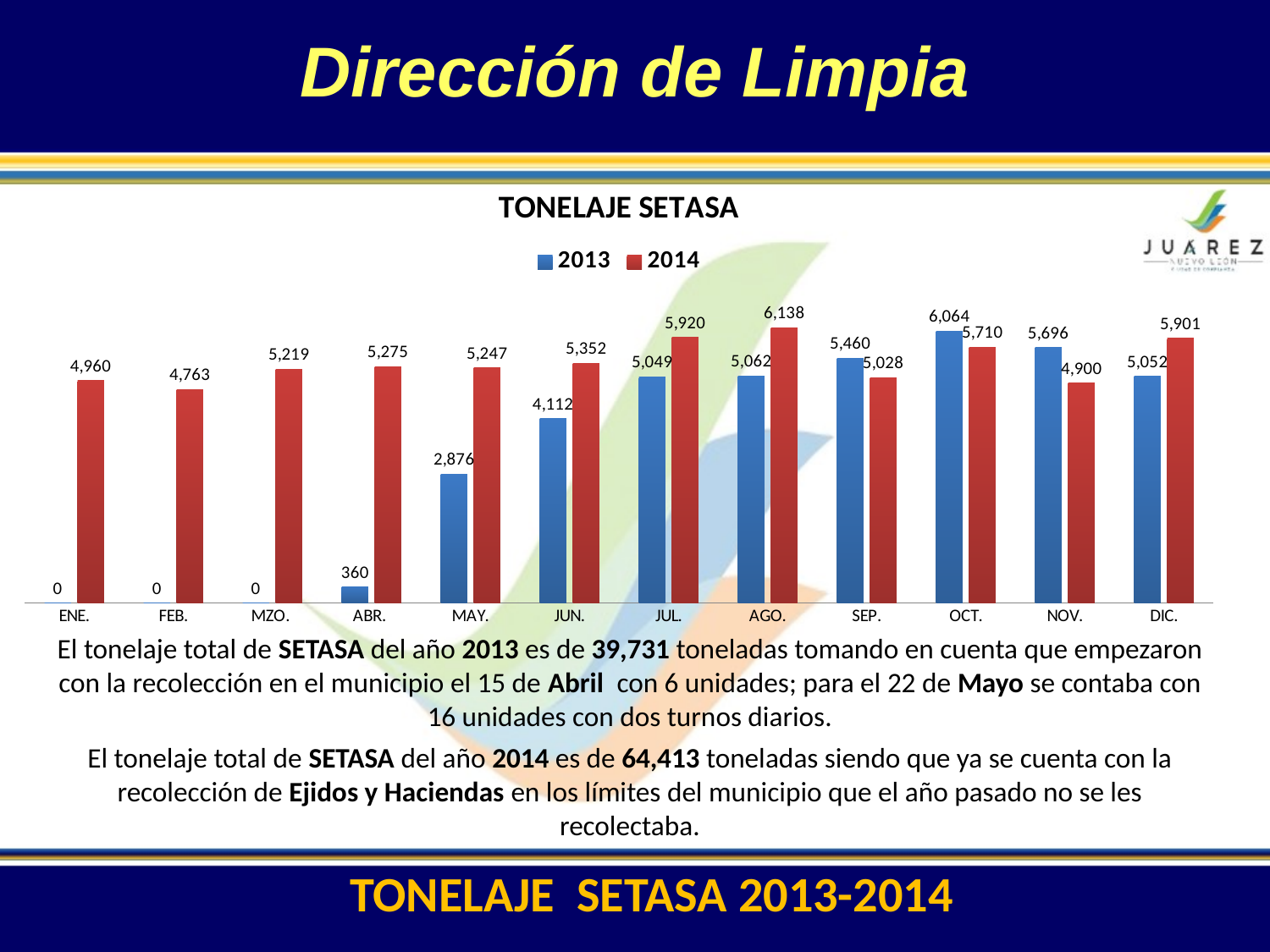
What kind of chart is the TONELAJE SETASA chart? Bar chart What is the 2014 value for ENE. in the TONELAJE SETASA chart? 4,960 What is the 2013 value for ABR. in the TONELAJE SETASA chart? 360 Which colour represents the 2014 series in the TONELAJE SETASA chart? Red What is the difference between the 2014 and 2013 values for AGO. in the TONELAJE SETASA chart? 1,076 Which month has the highest 2013 value in the TONELAJE SETASA chart? OCT. Which month has the highest 2014 value in the TONELAJE SETASA chart? AGO. In the TONELAJE SETASA chart, which series has the larger value for SEP., 2013 or 2014? 2013 How many months are shown on the x axis of the TONELAJE SETASA chart? 12 What is the 2013 value for MAY. in the TONELAJE SETASA chart? 2,876 How many series does the legend of the TONELAJE SETASA chart list? 2 Which month has the lowest 2014 value in the TONELAJE SETASA chart? FEB.